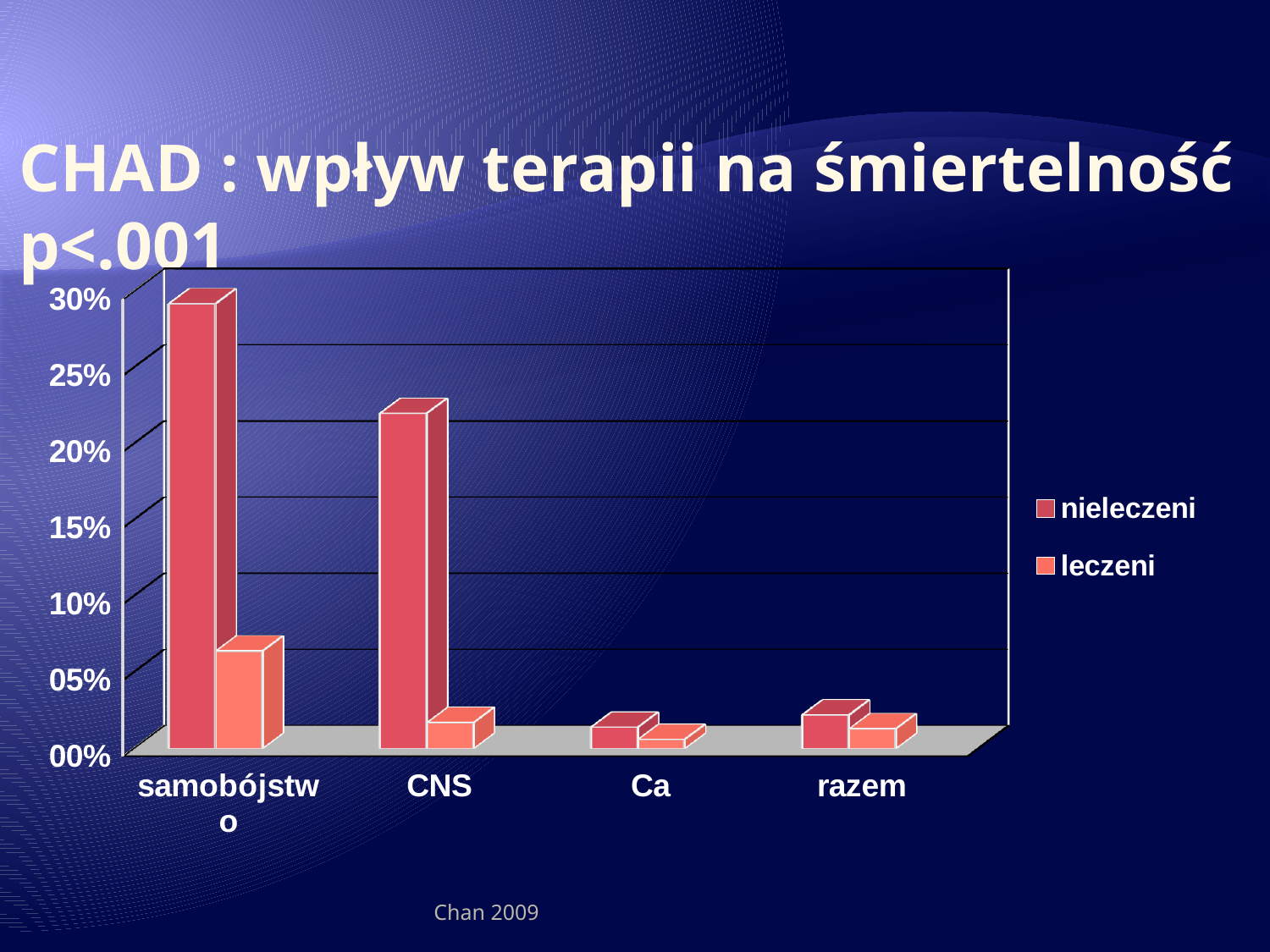
How many categories are shown on the x axis of the chart? 4 What kind of chart is shown on the slide? bar chart Which category has the highest value for the nieleczeni series? samobójstwo Which is larger: the nieleczeni value for samobójstwo or the nieleczeni value for CNS? samobójstwo How many series does the chart's legend list? 2 For the CNS category, which series has the larger value, nieleczeni or leczeni? nieleczeni Which series are listed in the chart's legend? nieleczeni, leczeni Which category has the highest value for the leczeni series? samobójstwo Is the leczeni value for CNS greater or less than 5%? less Is the nieleczeni value for samobójstwo greater or less than 25%? greater Is the nieleczeni value for CNS greater or less than 20%? greater